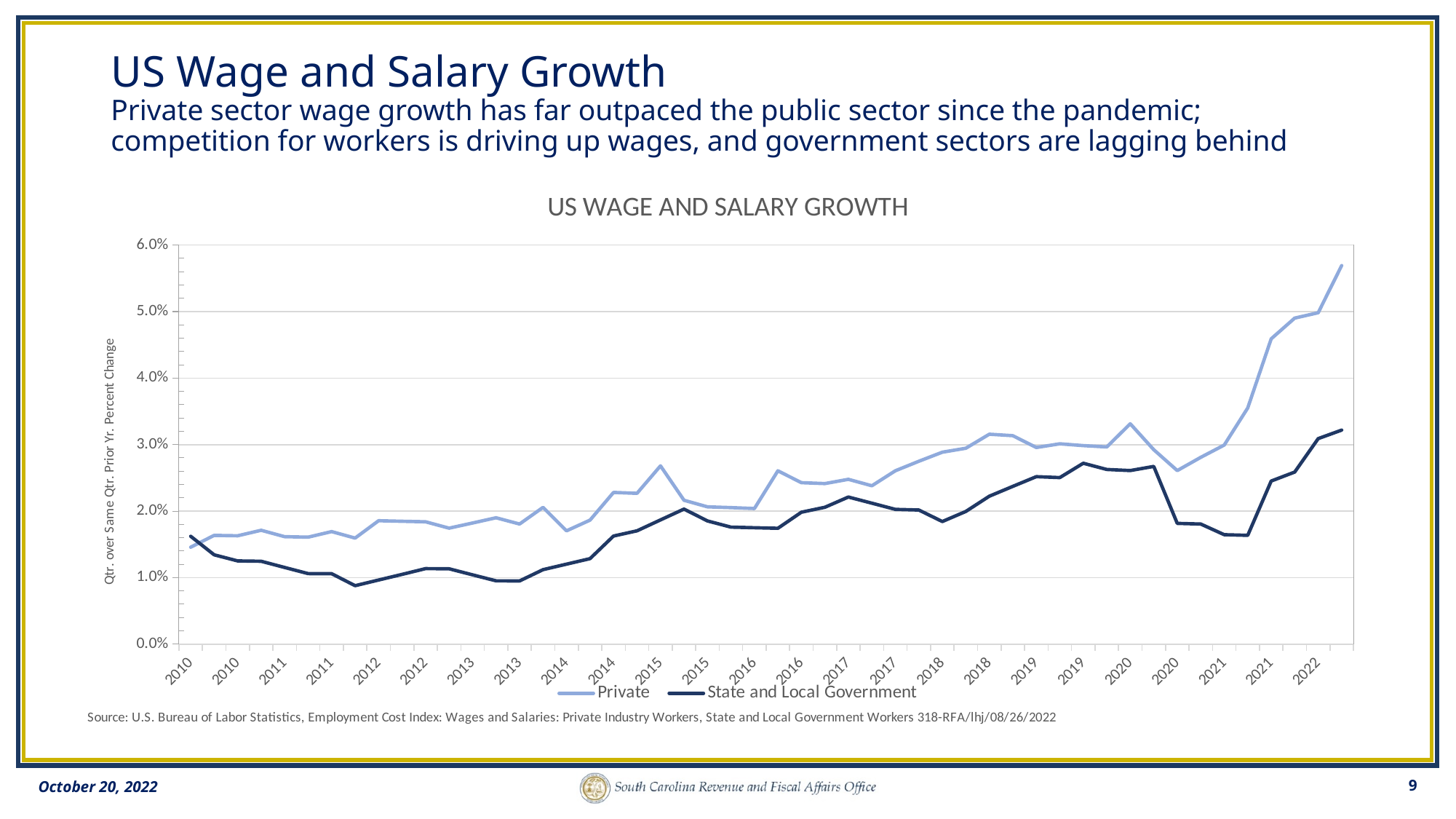
Which series reaches the highest value anywhere on the chart? Private Is the value for the Private series at the last point on the chart greater or less than 5.0%? greater Which series is higher at the first point on the chart (2010)? State and Local Government Does the Private series rise or fall between 2020 and the end of 2022? Rise Which series is higher at the last point on the chart (2022)? Private What kind of chart is shown on the slide? Line chart Is the lowest value of the State and Local Government series greater or less than 1.0%? less What are the two series named in the chart's legend? Private; State and Local Government What is the label on the chart's vertical axis? Qtr. over Same Qtr. Prior Yr. Percent Change Is the value for the State and Local Government series at the last point on the chart greater or less than 3.0%? greater How many series does the chart's legend list? 2